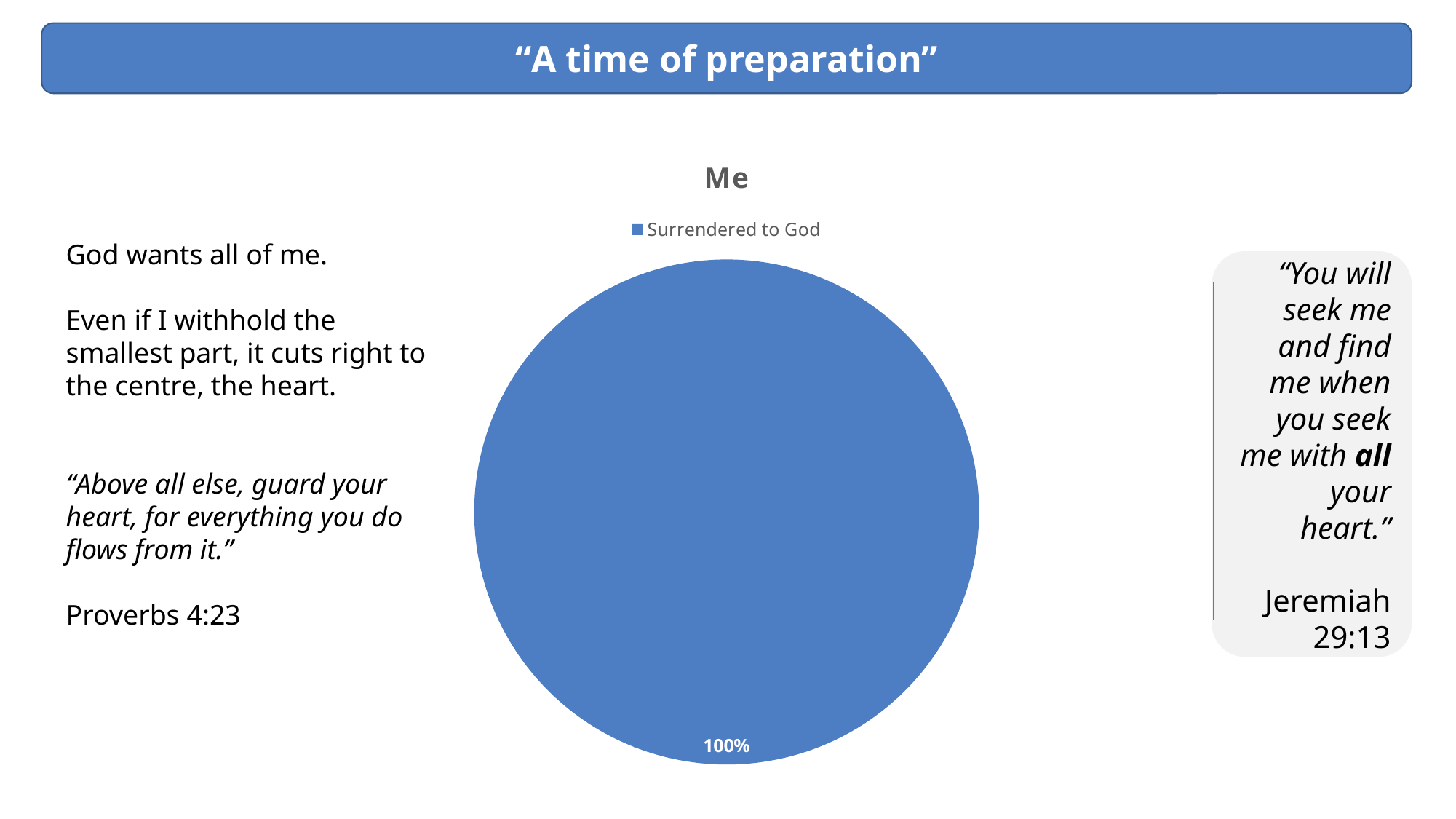
Which category is the largest in the pie chart? Surrendered to God What kind of chart is shown on the slide? pie chart What value is printed on the "Surrendered to God" slice? 100% What is the legend entry for the chart? Surrendered to God What share of the pie does "Surrendered to God" take? 100% How many slices does the pie chart have? 1 What is the title of the chart? Me How many entries does the chart legend list? 1